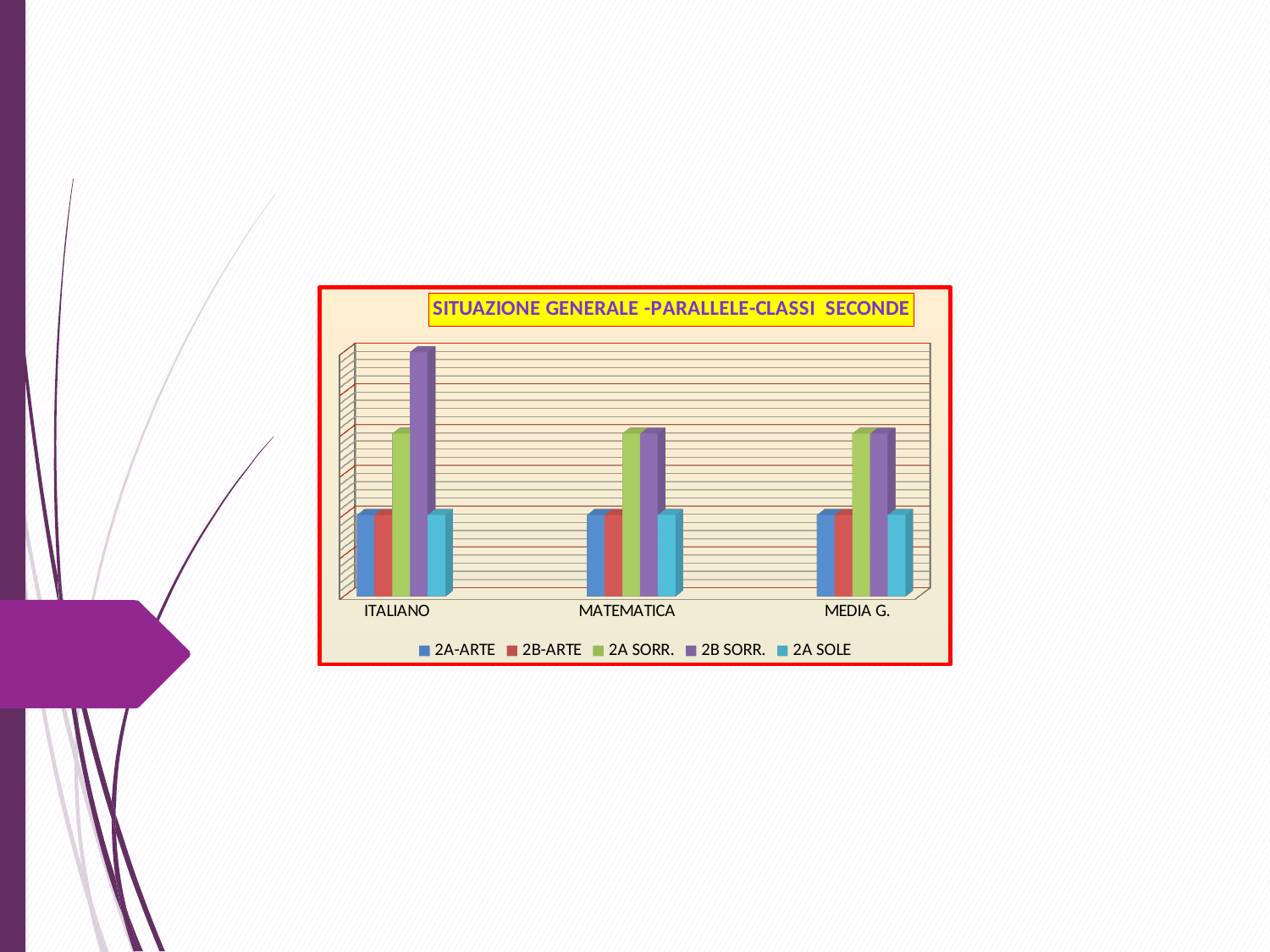
Which series has the highest bar in the ITALIANO category? 2B SORR. In the MATEMATICA category, which is larger: the bar for 2A SORR. or the bar for 2B-ARTE? 2A SORR. How many series does the chart's legend list? 5 What is the title of the chart? SITUAZIONE GENERALE -PARALLELE-CLASSI SECONDE Does the value for 2B SORR. rise or fall from ITALIANO to MATEMATICA? fall What kind of chart is shown on the slide? bar chart Which series is shown in purple in the chart's legend? 2B SORR. In the ITALIANO category, which is larger: the bar for 2B SORR. or the bar for 2A-ARTE? 2B SORR. How many categories are shown on the x axis of the chart? 3 For the 2B SORR. series, which category has the larger bar: ITALIANO or MATEMATICA? ITALIANO What is the label of the third category on the x axis? MEDIA G. In which category does the tallest bar of the whole chart appear? ITALIANO